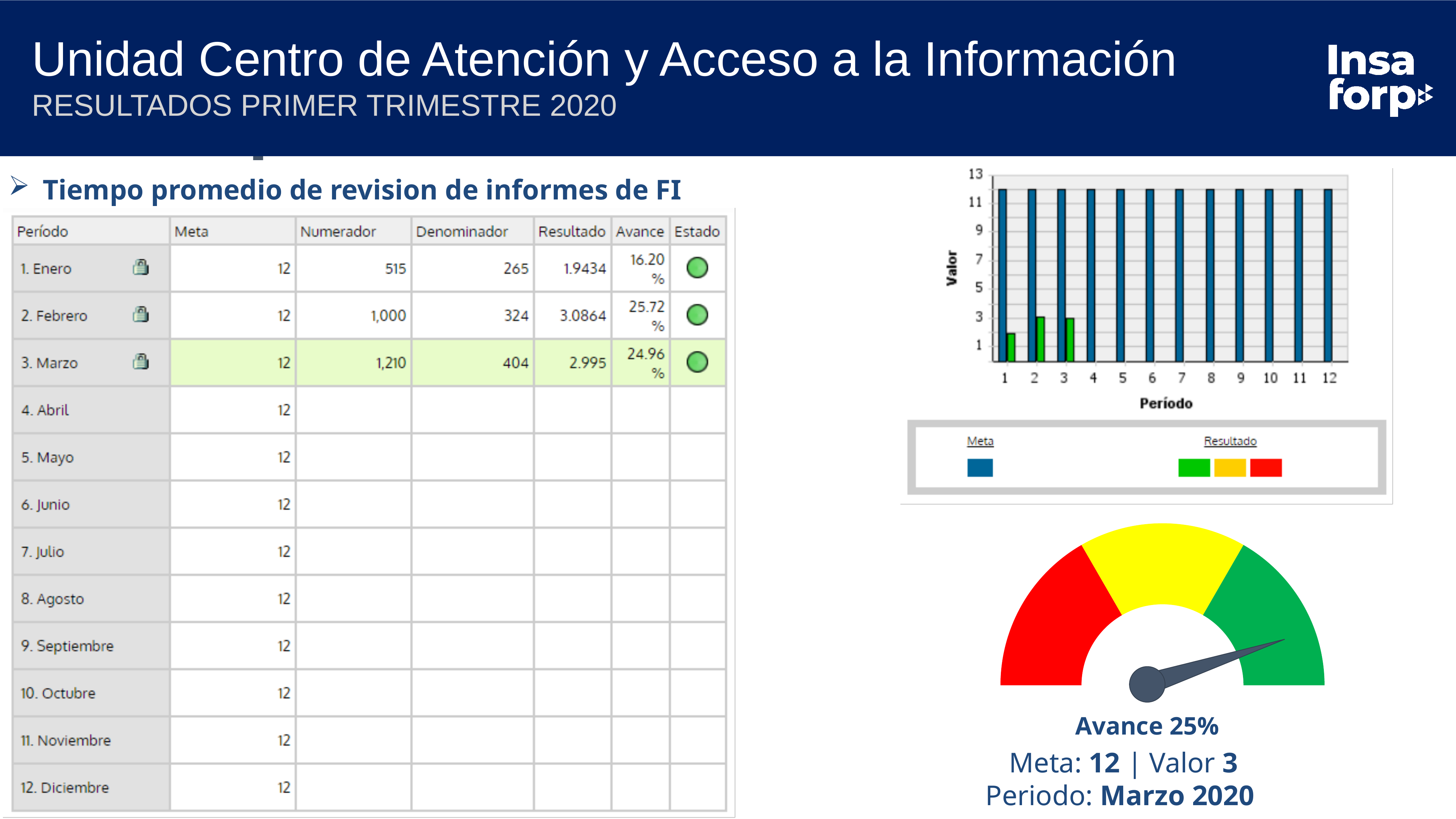
What kind of chart is the chart at the top right of the slide? bar chart In the bar chart at the top right, is the Resultado value for period 2 greater or less than 1? greater In the bar chart at the top right, do the Meta values rise, fall or stay flat across periods 1 to 12? stay flat In the bar chart at the top right, is the Meta value for period 1 greater or less than 11? greater What Avance percentage is shown below the gauge chart at the bottom right? 25% In the bar chart at the top right, which is larger for period 3, Meta or Resultado? Meta In the bar chart at the top right, how many series does the legend list? 2 In the bar chart at the top right, what colour does the legend show for Meta? blue In the bar chart at the top right, how many periods are shown on the x axis? 12 In the bar chart at the top right, what is the title of the y axis? Valor In the bar chart at the top right, is the Resultado value for period 1 greater or less than 3? less In the bar chart at the top right, which of periods 1, 2 and 3 has the lowest Resultado value? 1